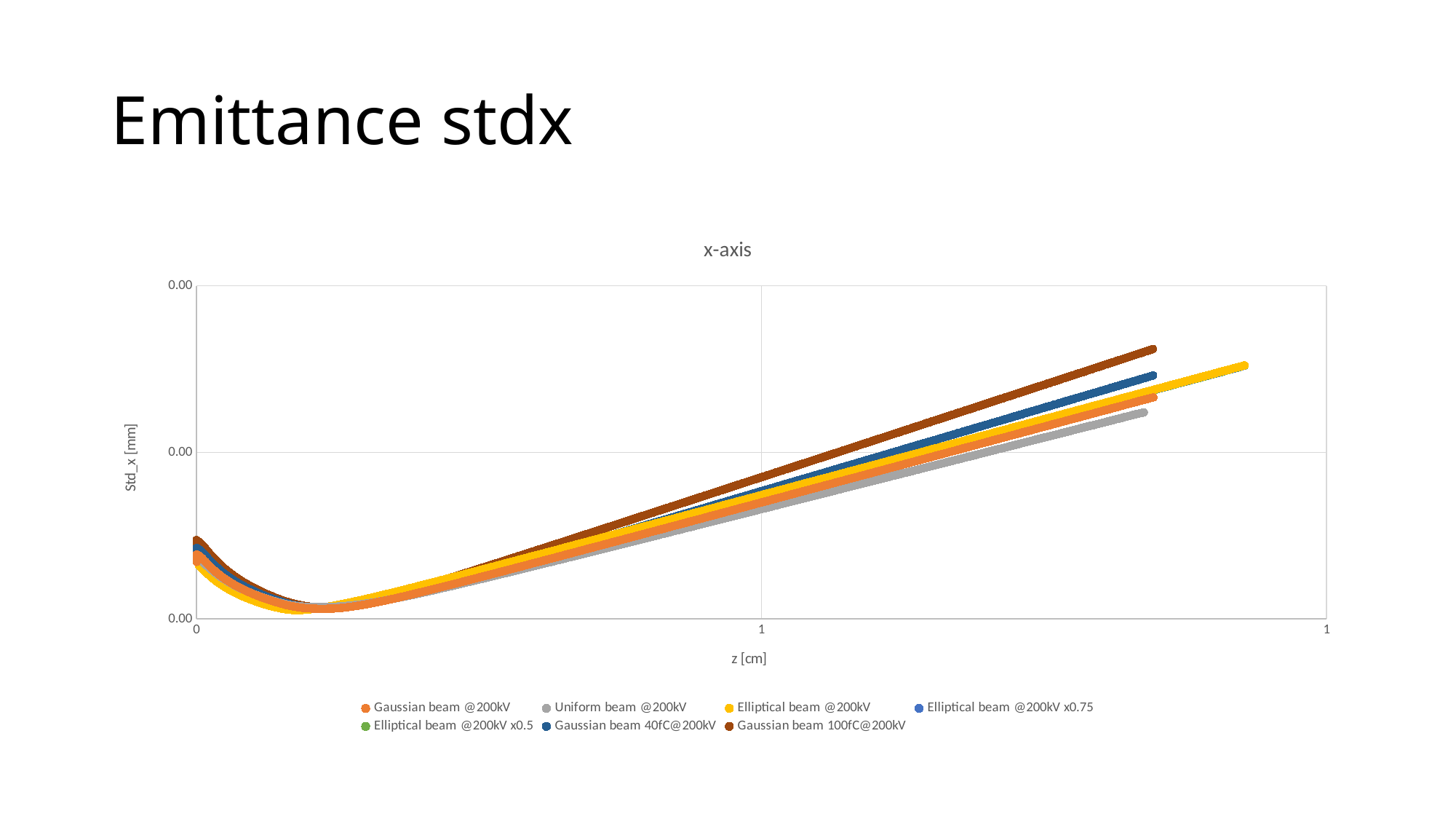
Do the Std_x curves rise or fall immediately after z = 0, before reaching their minimum? fall What is the title shown above the chart? x-axis Which series reaches the highest Std_x value at the right end of the chart? Gaussian beam 100fC@200kV Which series ends with the lowest Std_x value at the right end of the chart? Uniform beam @200kV Which series extends furthest along the z axis? Elliptical beam @200kV What kind of chart is shown on the slide? line chart How many series does the chart legend list? 7 What is the label of the horizontal axis of the chart? z [cm] At the right end of the chart, which series has the larger Std_x value: Gaussian beam 40fC@200kV or Gaussian beam @200kV? Gaussian beam 40fC@200kV At the right end of the chart, which series has the larger Std_x value: Gaussian beam 100fC@200kV or Uniform beam @200kV? Gaussian beam 100fC@200kV After reaching their minimum near the left of the chart, do the Std_x curves rise or fall as z increases? rise